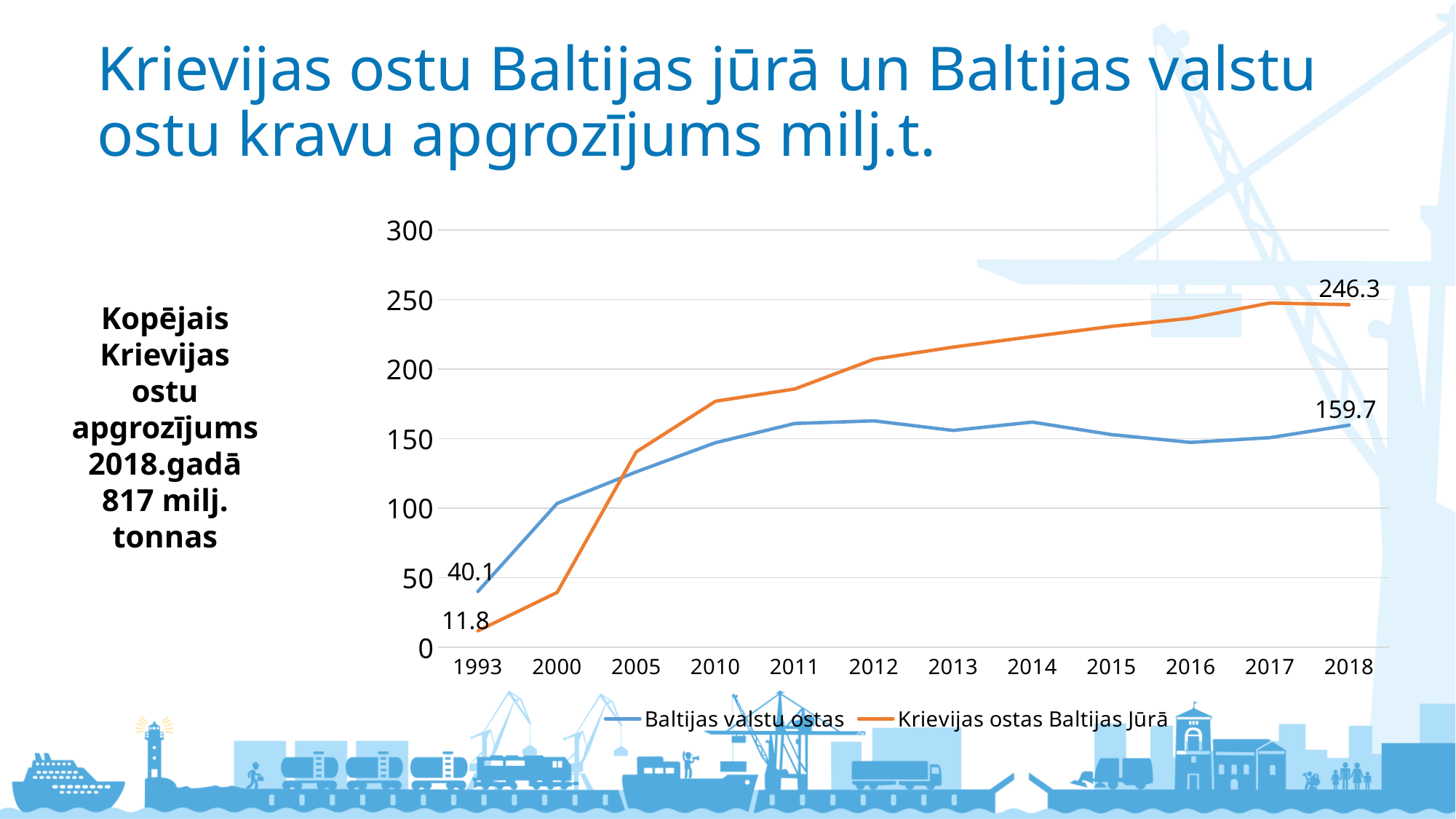
Is the value for Krievijas ostas Baltijas Jūrā in 2010 greater or less than 150? greater What is the value for Krievijas ostas Baltijas Jūrā in 2018? 246.3 What is the difference between the 1993 values of Baltijas valstu ostas and Krievijas ostas Baltijas Jūrā? 28.3 What is the value for Baltijas valstu ostas in 1993? 40.1 How many years are shown on the x axis? 12 What kind of chart is shown on the slide? line chart Which series has the larger value in 1993? Baltijas valstu ostas What is the difference between the 2018 values of Krievijas ostas Baltijas Jūrā and Baltijas valstu ostas? 86.6 What is the value for Baltijas valstu ostas in 2018? 159.7 How many series does the legend list? 2 Which series has the larger value in 2018? Krievijas ostas Baltijas Jūrā What is the value for Krievijas ostas Baltijas Jūrā in 1993? 11.8